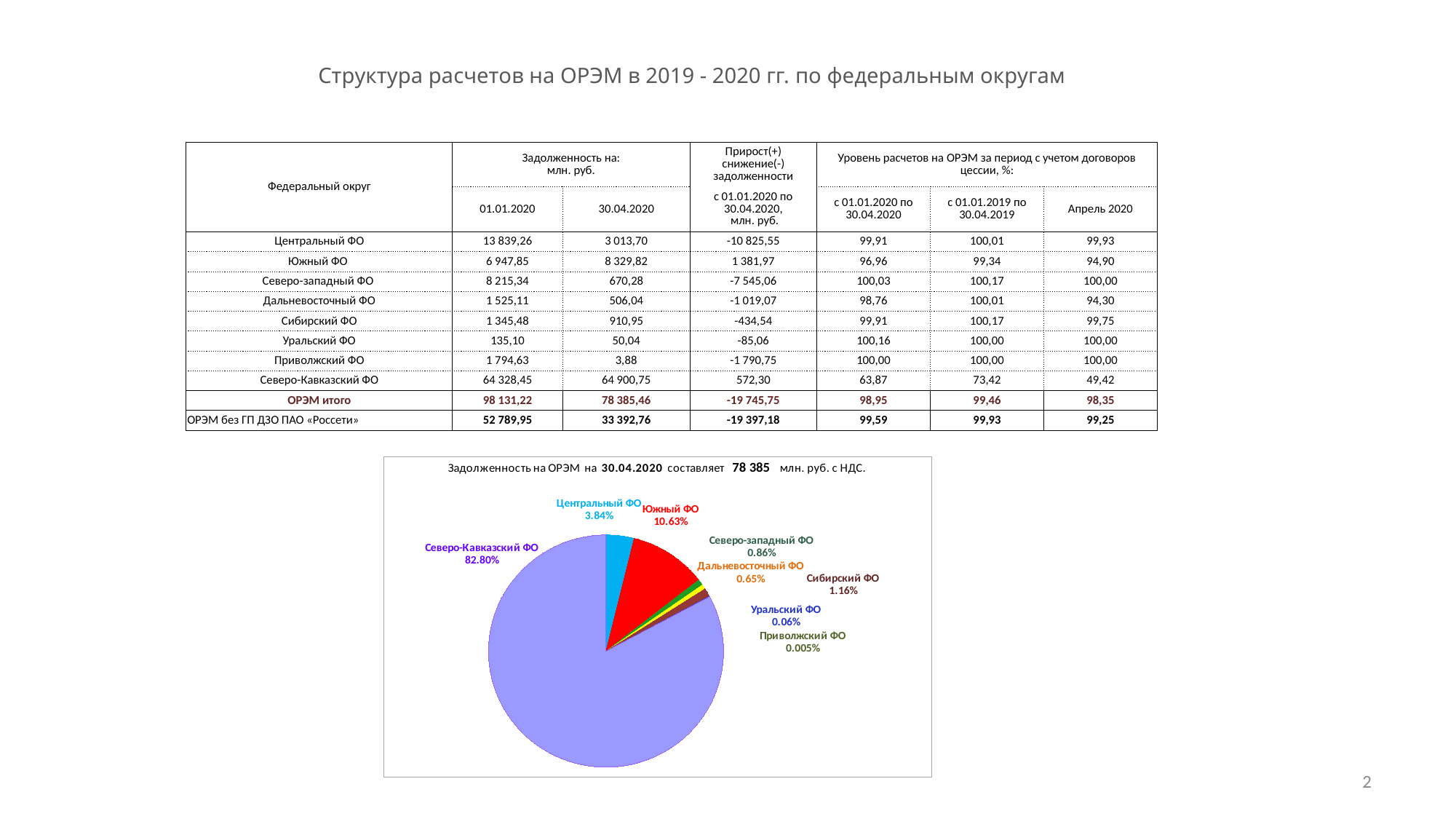
How many slices does the pie chart have? 8 According to the pie chart's title, what is the total debt on ОРЭМ as of 30.04.2020? 78 385 млн. руб. с НДС Which federal district has the smallest share in the pie chart? Приволжский ФО What share of the pie chart does Южный ФО account for? 10.63% What kind of chart is shown on the slide? pie chart What is the share shown for Сибирский ФО in the pie chart? 1.16% By how many percentage points does the share of Северо-Кавказский ФО exceed that of Южный ФО in the pie chart? 72.17% Which has the larger share in the pie chart, Южный ФО or Центральный ФО? Южный ФО What is the share shown for Центральный ФО in the pie chart? 3.84% Which federal district has the largest share in the pie chart? Северо-Кавказский ФО What is the share shown for Уральский ФО in the pie chart? 0.06% What share of the pie chart does Северо-Кавказский ФО account for? 82.80%